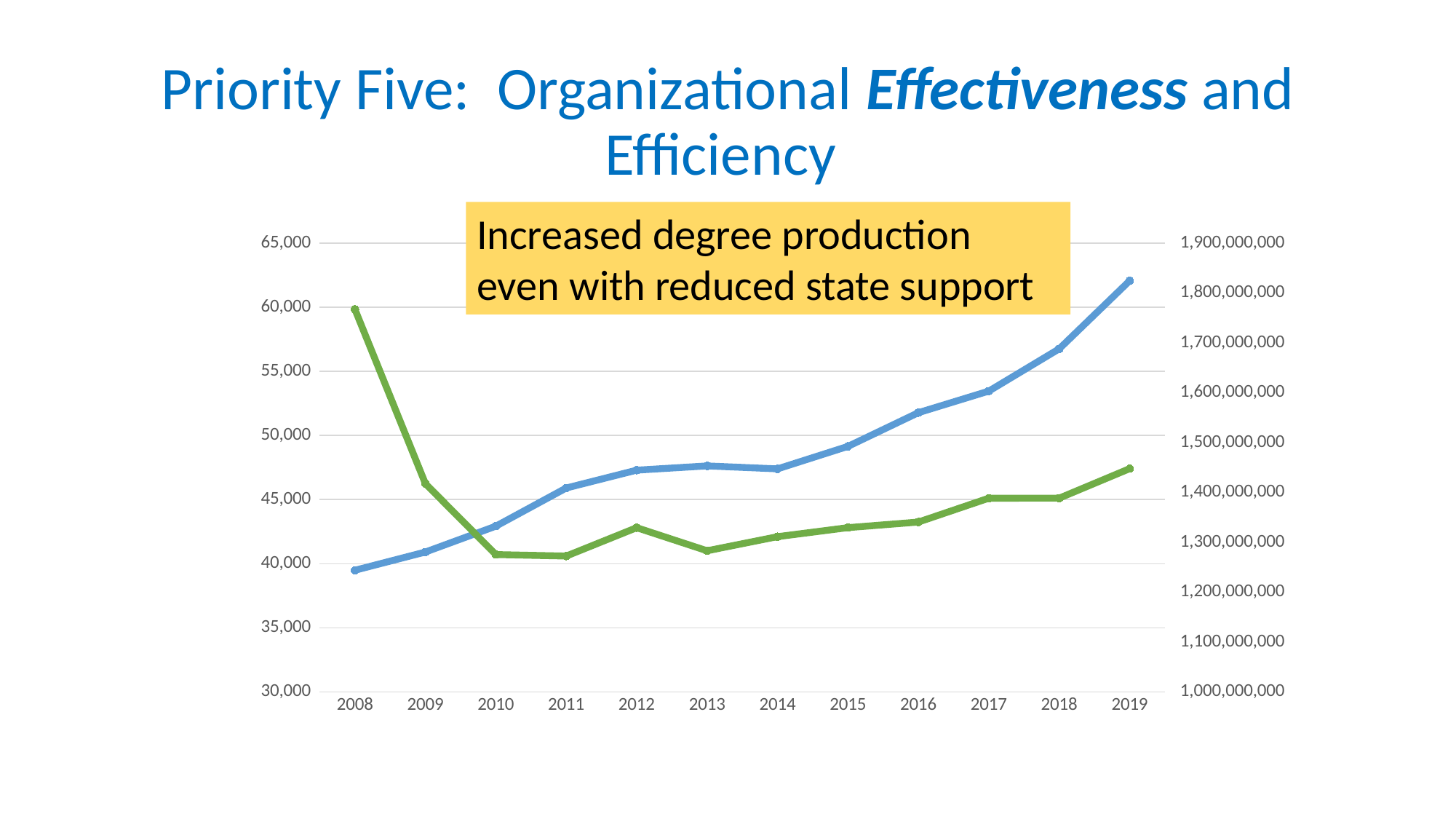
In which year does the green line reach its highest point? 2008 What is the first year shown on the x axis? 2008 In 2019, which line is higher on the chart, the blue line or the green line? blue line In 2008, which line is higher on the chart, the blue line or the green line? green line How many lines are plotted on the chart? 2 In which year does the blue line reach its highest point? 2019 What is the last year shown on the x axis? 2019 Does the blue line generally rise or fall from 2008 to 2019? rise What kind of chart is shown on the slide? line chart How many years are plotted along the x axis of the chart? 12 In which year is the blue line at its lowest point? 2008 What does the yellow text box on the chart say? Increased degree production even with reduced state support